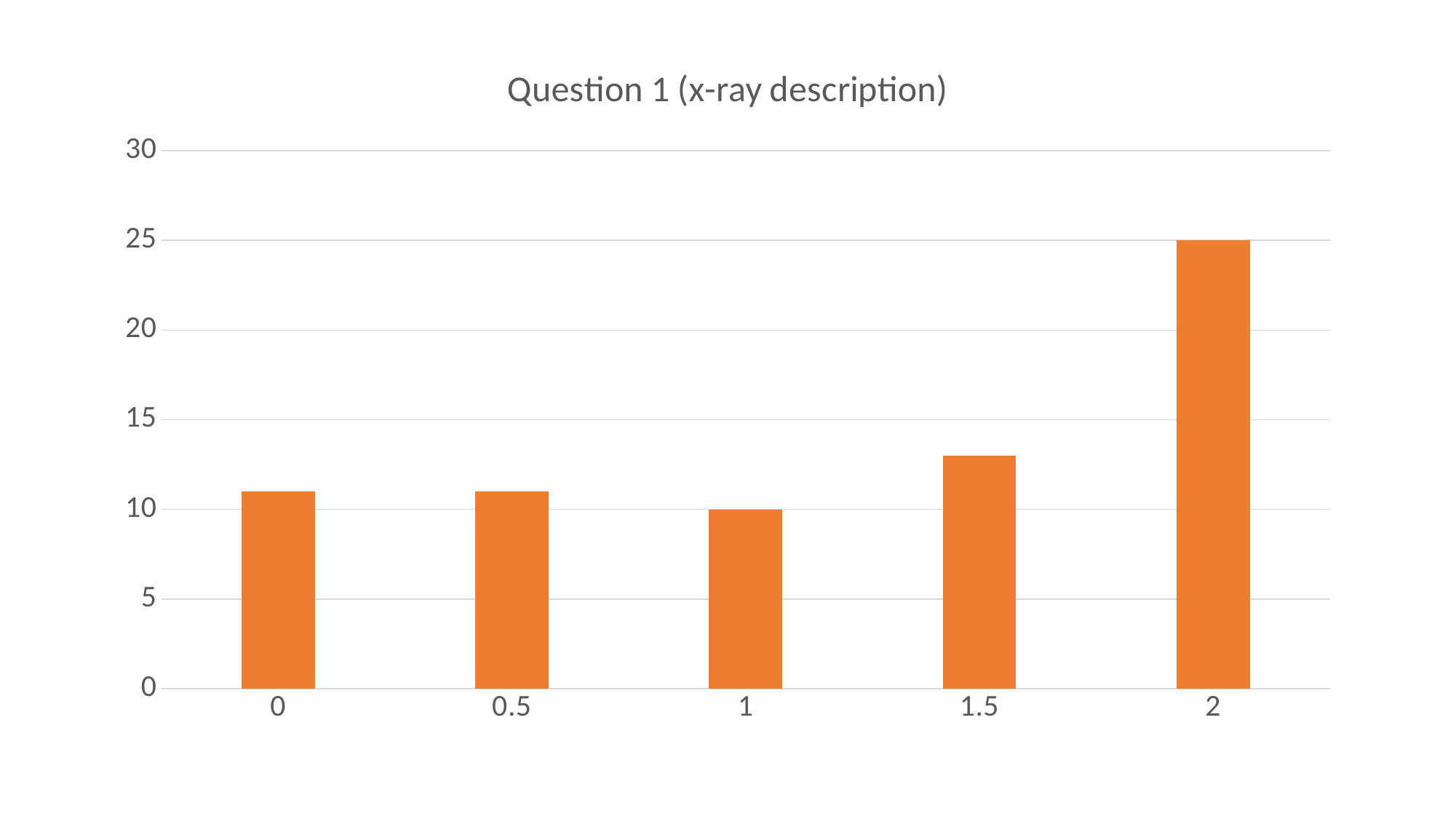
What is the value for category 1? 10 Which category has the highest bar? 2 What kind of chart is shown on the slide? bar chart How many bars are plotted in the chart? 5 What is the difference between the values for category 2 and category 1? 15 What is the value for category 2? 25 Is the value for category 1.5 greater or less than 15? less What is the title of the chart? Question 1 (x-ray description) Which has the larger value, category 1.5 or category 0.5? 1.5 Which has the larger value, category 2 or category 1.5? 2 Is the value for category 2 greater or less than 20? greater Is the value for category 0 greater or less than 10? greater